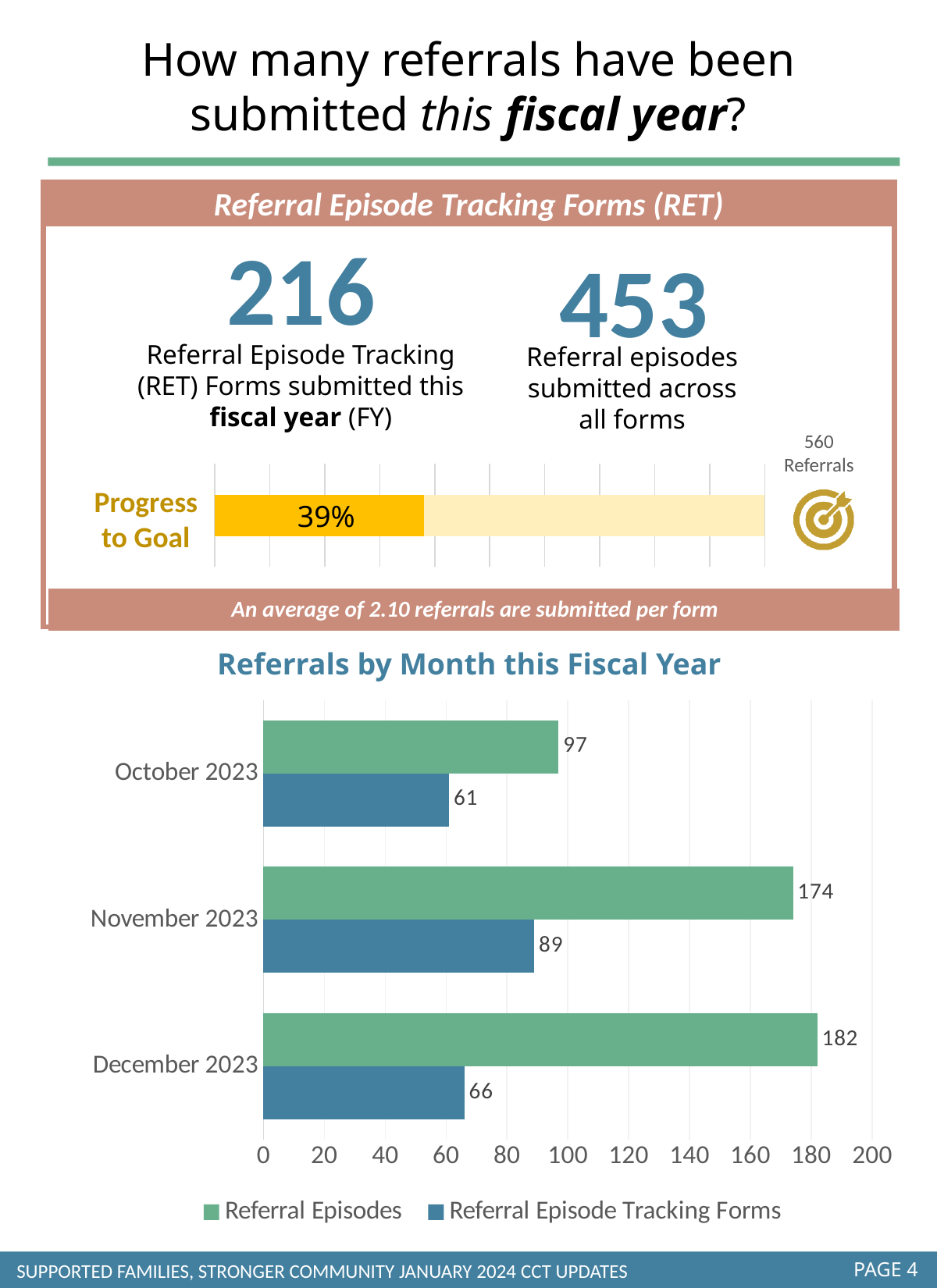
In the 'Referrals by Month this Fiscal Year' chart, what is the value of Referral Episodes for November 2023? 174 In the 'Referrals by Month this Fiscal Year' chart, is the value of Referral Episodes for December 2023 greater or less than 160? greater In the 'Referrals by Month this Fiscal Year' chart, which month has the highest number of Referral Episodes? December 2023 How many months are shown in the 'Referrals by Month this Fiscal Year' chart? 3 In the 'Referrals by Month this Fiscal Year' chart, which is larger: Referral Episodes in October 2023 or Referral Episode Tracking Forms in November 2023? Referral Episodes in October 2023 What percentage does the 'Progress to Goal' bar in the Referral Episode Tracking Forms (RET) box show? 39% In the 'Referrals by Month this Fiscal Year' chart, which month has the lowest number of Referral Episode Tracking Forms? October 2023 In the 'Referrals by Month this Fiscal Year' chart, what is the value of Referral Episode Tracking Forms for October 2023? 61 What kind of chart is 'Referrals by Month this Fiscal Year'? Bar chart In the 'Referrals by Month this Fiscal Year' chart, what is the value of Referral Episode Tracking Forms for December 2023? 66 How many series does the legend of the 'Referrals by Month this Fiscal Year' chart list? 2 In the 'Referrals by Month this Fiscal Year' chart, what is the difference between Referral Episodes and Referral Episode Tracking Forms for November 2023? 85